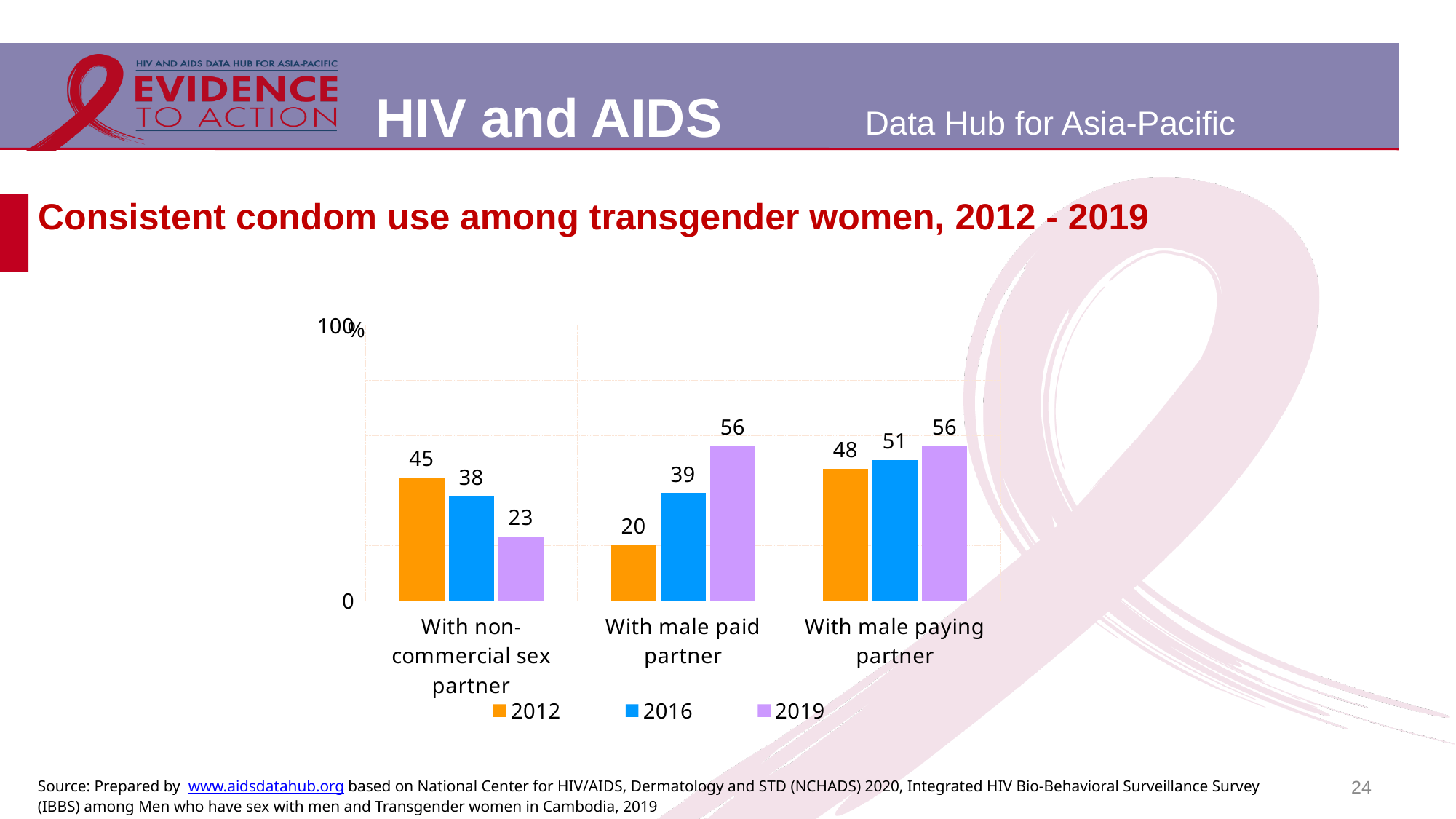
What is the 2019 value for consistent condom use with male paid partner? 56 How many series does the legend list? 3 What is the 2012 value for consistent condom use with non-commercial sex partner? 45 Which category has the lowest 2012 value? With male paid partner Which year has the highest value for the non-commercial sex partner category? 2012 Do the values for the male paid partner category rise or fall from 2012 to 2019? rise What is the 2016 value for consistent condom use with male paying partner? 51 Is the 2016 value for non-commercial sex partner larger or smaller than the 2016 value for male paid partner? smaller Which colour represents the 2019 series in the legend? purple What kind of chart is shown on the slide? bar chart What is the difference between the 2019 and 2012 values for the male paid partner category? 36 How many categories are shown on the x axis? 3